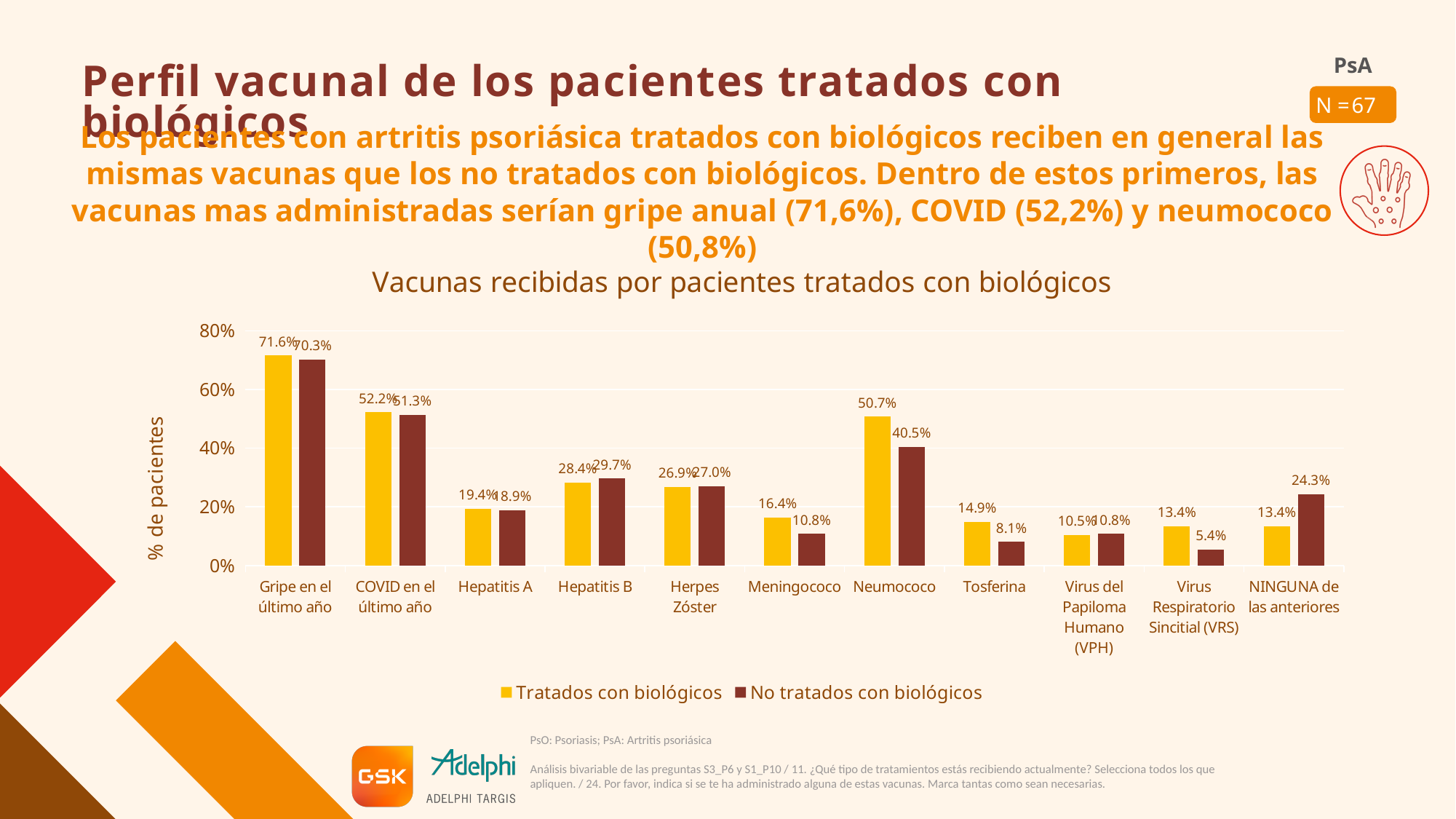
For 'NINGUNA de las anteriores', which series has the larger value? No tratados con biológicos How many series does the legend list? 2 What is the value for 'No tratados con biológicos' in the Tosferina category? 8.1% Which category has the lowest value for the 'No tratados con biológicos' series? Virus Respiratorio Sincitial (VRS) What percentage of patients treated with biologics received the Neumococo vaccine? 50.7% What is the difference between the 'Tratados con biológicos' and 'No tratados con biológicos' values for Neumococo? 10.2% How many vaccine categories are shown on the x axis? 11 What type of chart is shown on the slide? Bar chart What is the title of the chart? Vacunas recibidas por pacientes tratados con biológicos Which category has the highest value for the 'Tratados con biológicos' series? Gripe en el último año What is the value for 'Tratados con biológicos' in the Meningococo category? 16.4% For Virus Respiratorio Sincitial (VRS), which series has the larger value? Tratados con biológicos